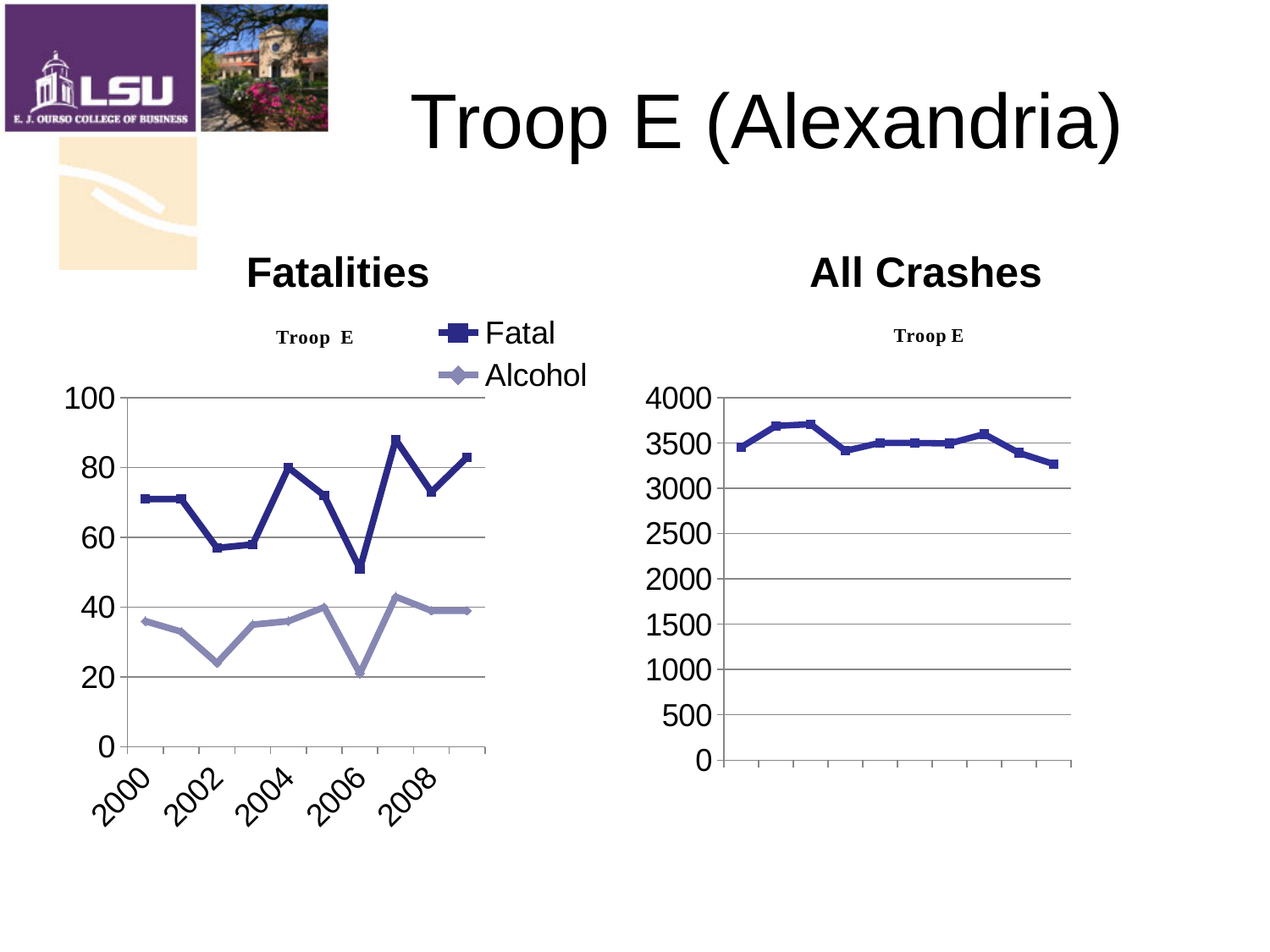
In the Fatalities chart, is the Alcohol value for 2002 greater or less than 40? less What kind of chart is the Fatalities chart on the left? line chart In the Fatalities chart, is the Fatal value for 2006 greater or less than 60? less How many data points are plotted in the All Crashes chart? 10 In the Fatalities chart, which series has the larger value in 2004, Fatal or Alcohol? Fatal What kind of chart is the All Crashes chart on the right? line chart In the All Crashes chart, is the last plotted value greater or less than 3500? less What are the two series named in the legend of the Fatalities chart? Fatal and Alcohol How many series does the legend of the Fatalities chart list? 2 In the Fatalities chart, which year has the highest value for the Fatal series? 2007 In the Fatalities chart, which year has the lowest value for the Fatal series? 2006